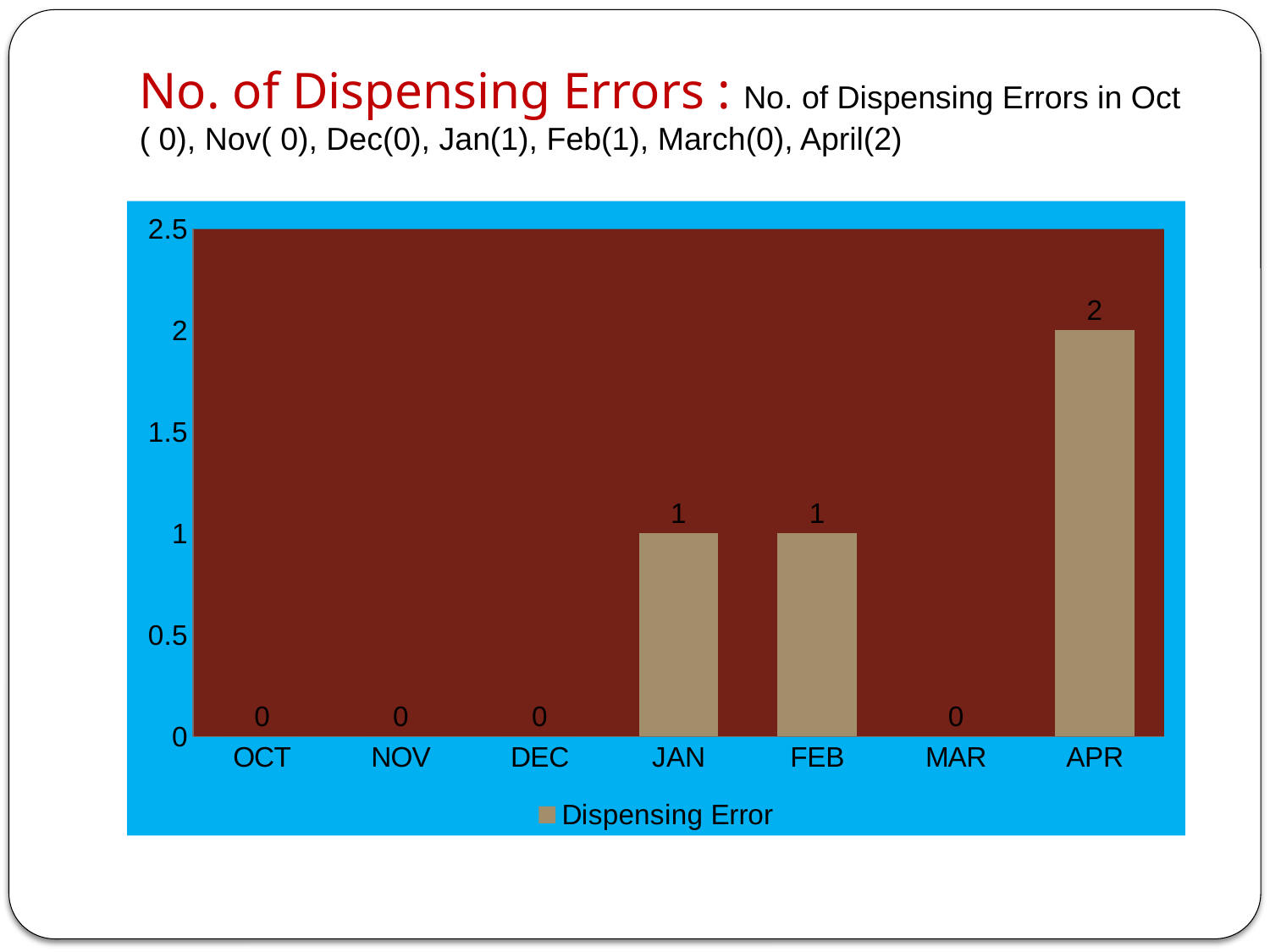
What kind of chart is shown? bar chart What is the legend entry for the series? Dispensing Error Is the value for APR greater or less than 1.5? greater What is the value for APR? 2 What is the total of the values for JAN, FEB and APR? 4 What is the value for JAN? 1 Which month has the highest number of dispensing errors? APR What is the difference between the values for APR and FEB? 1 How many months are shown on the x axis? 7 How many series does the legend list? 1 What is the value for MAR? 0 Which is larger, the value for APR or the value for JAN? APR